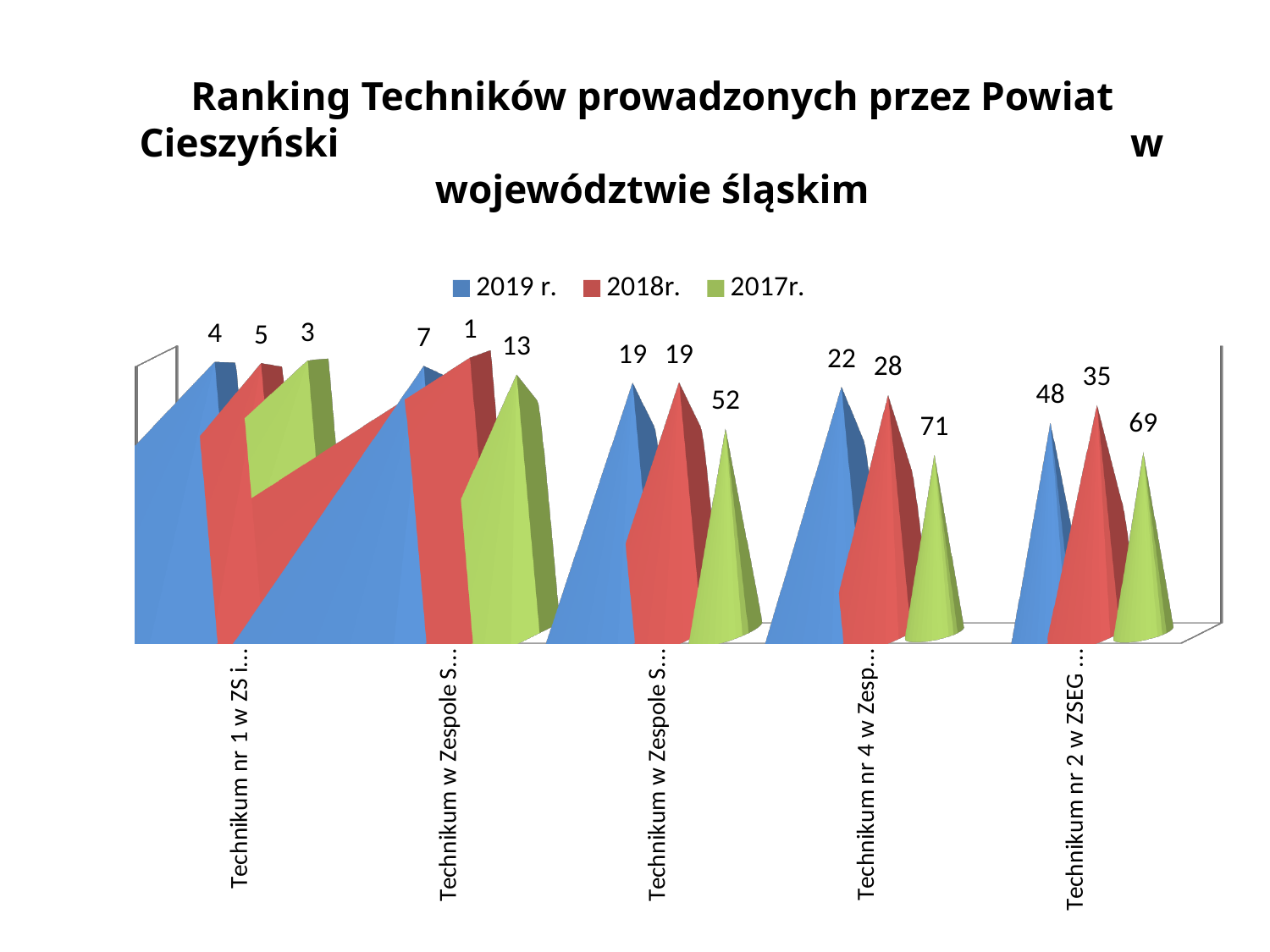
Which category has the lowest 2018r. value? The second category from the left (Technikum w Zespole S...) How many series does the legend list? 3 What kind of chart is shown on the slide? Bar chart (3D cone bars) What is the 2017r. value for Technikum nr 4 w Zesp...? 71 What is the 2017r. value for the second category from the left (Technikum w Zespole S...)? 13 How many categories are shown on the x axis? 5 What is the difference between the 2017r. and 2019 r. values for Technikum nr 4 w Zesp...? 49 What is the 2019 r. value for Technikum nr 1 w ZS i...? 4 Which category has the highest 2017r. value? Technikum nr 4 w Zesp... Which is larger for Technikum nr 2 w ZSEG...: the 2019 r. value or the 2018r. value? 2019 r. What is the 2018r. value for Technikum nr 2 w ZSEG...? 35 Which series is shown in green in the legend? 2017r.